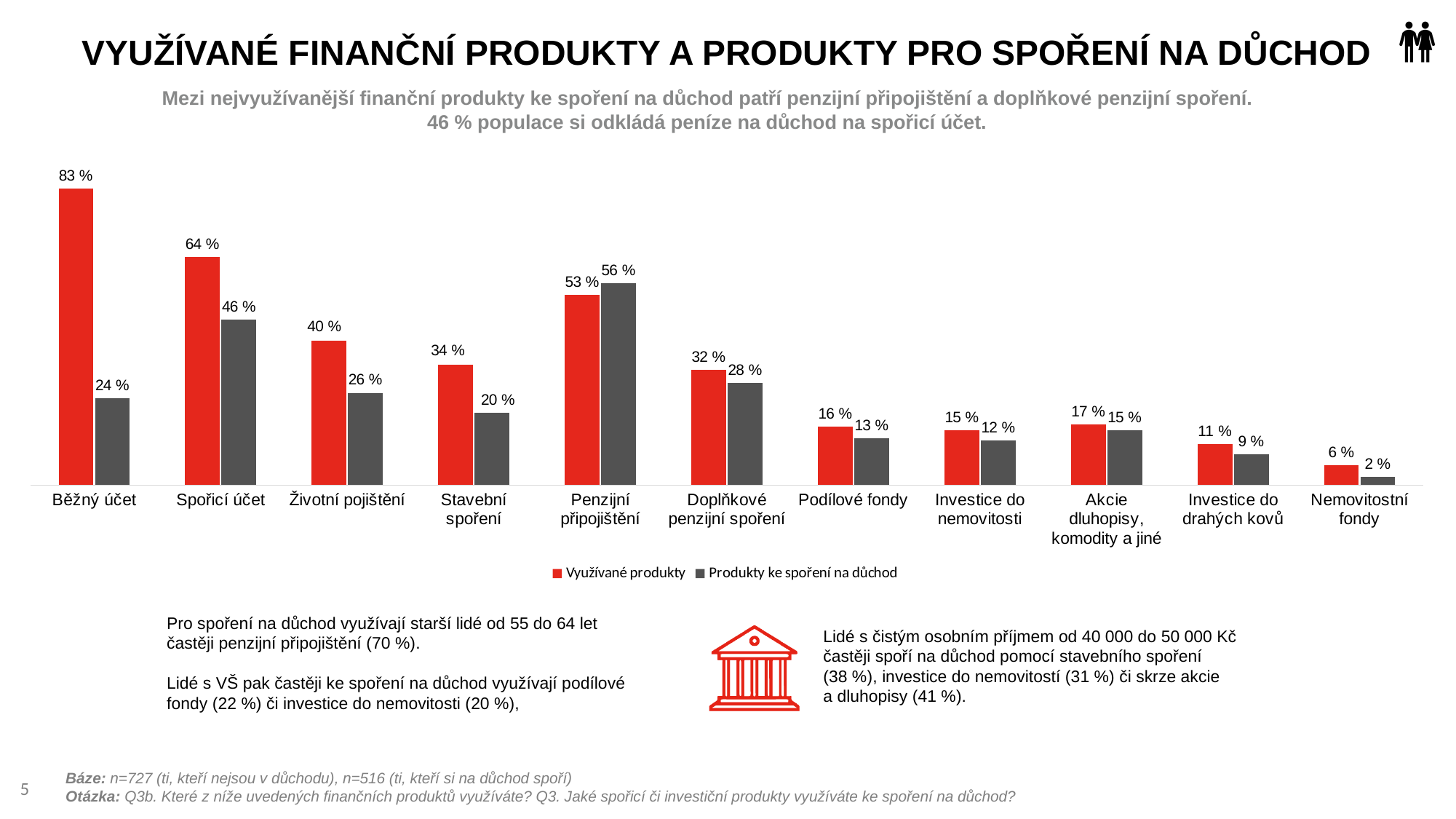
What is the value of 'Produkty ke spoření na důchod' for Penzijní připojištění? 56 % What is the value of 'Využívané produkty' for Akcie dluhopisy, komodity a jiné? 17 % Which category has the lowest value for 'Produkty ke spoření na důchod'? Nemovitostní fondy What is the value of 'Produkty ke spoření na důchod' for Spořicí účet? 46 % How many series does the legend list? 2 Which colour represents the series 'Využívané produkty' in the legend? Red What is the value of 'Využívané produkty' for Běžný účet? 83 % For Penzijní připojištění, which series has the larger value: 'Využívané produkty' or 'Produkty ke spoření na důchod'? Produkty ke spoření na důchod What kind of chart is shown on the slide? Bar chart How many categories are shown on the x axis of the chart? 11 What is the difference between 'Využívané produkty' and 'Produkty ke spoření na důchod' for Běžný účet? 59 % Which category has the highest value for 'Využívané produkty'? Běžný účet